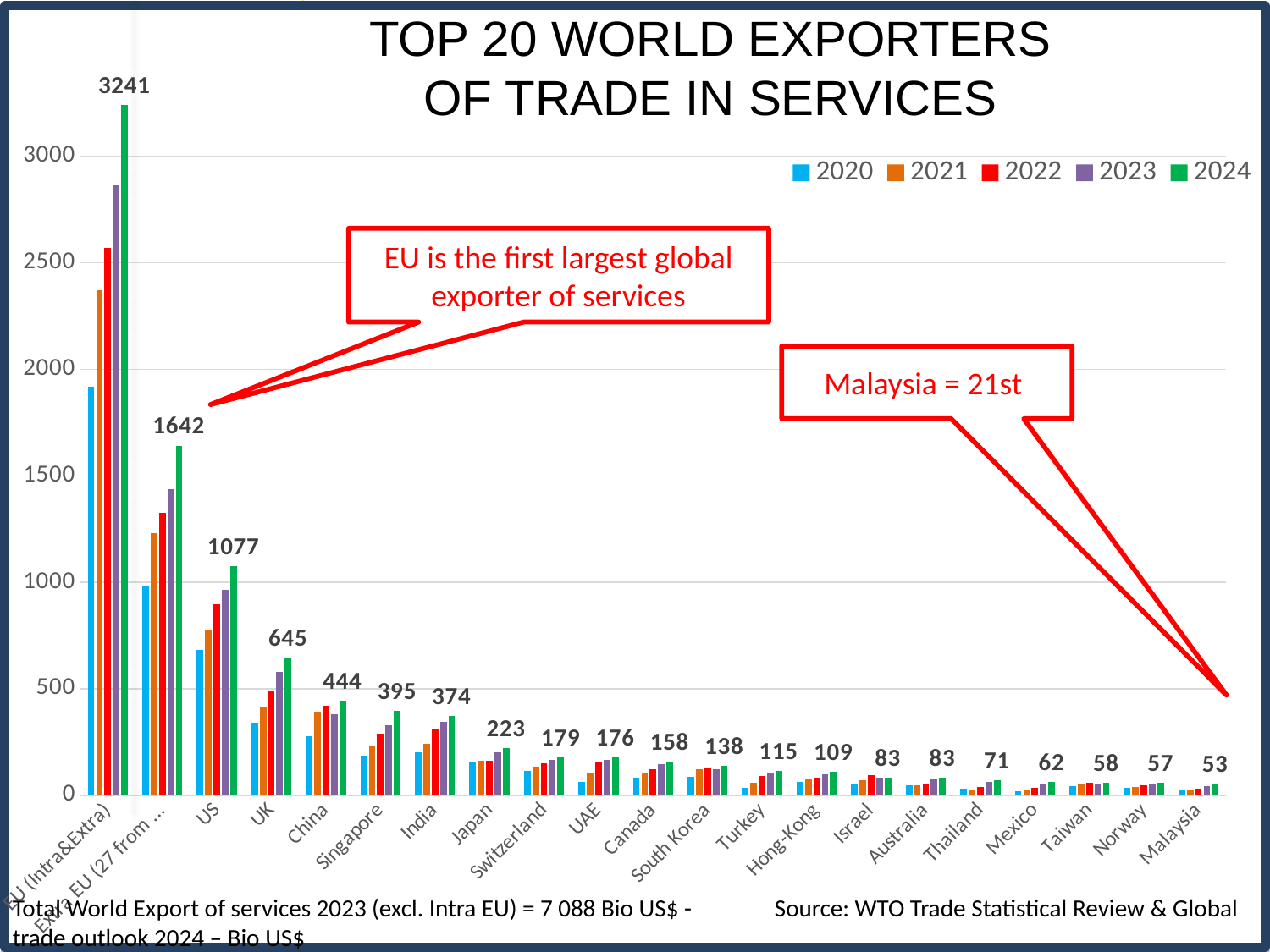
Which has the larger 2024 value, Japan or Switzerland? Japan Which category has the highest 2024 value? EU (Intra&Extra) What is the 2024 value labelled for Malaysia? 53 Is the 2020 value for the US greater or less than 500? greater What is the 2024 value labelled for the US? 1077 Which category has the lowest 2024 value? Malaysia How many series does the legend list? 5 What is the difference between the 2024 values labelled for the US and the UK? 432 Which year does the green series in the legend represent? 2024 What is the 2024 value labelled for Singapore? 395 Do the 2024 values rise or fall moving from left to right along the x axis? fall What kind of chart is shown on the slide? bar chart